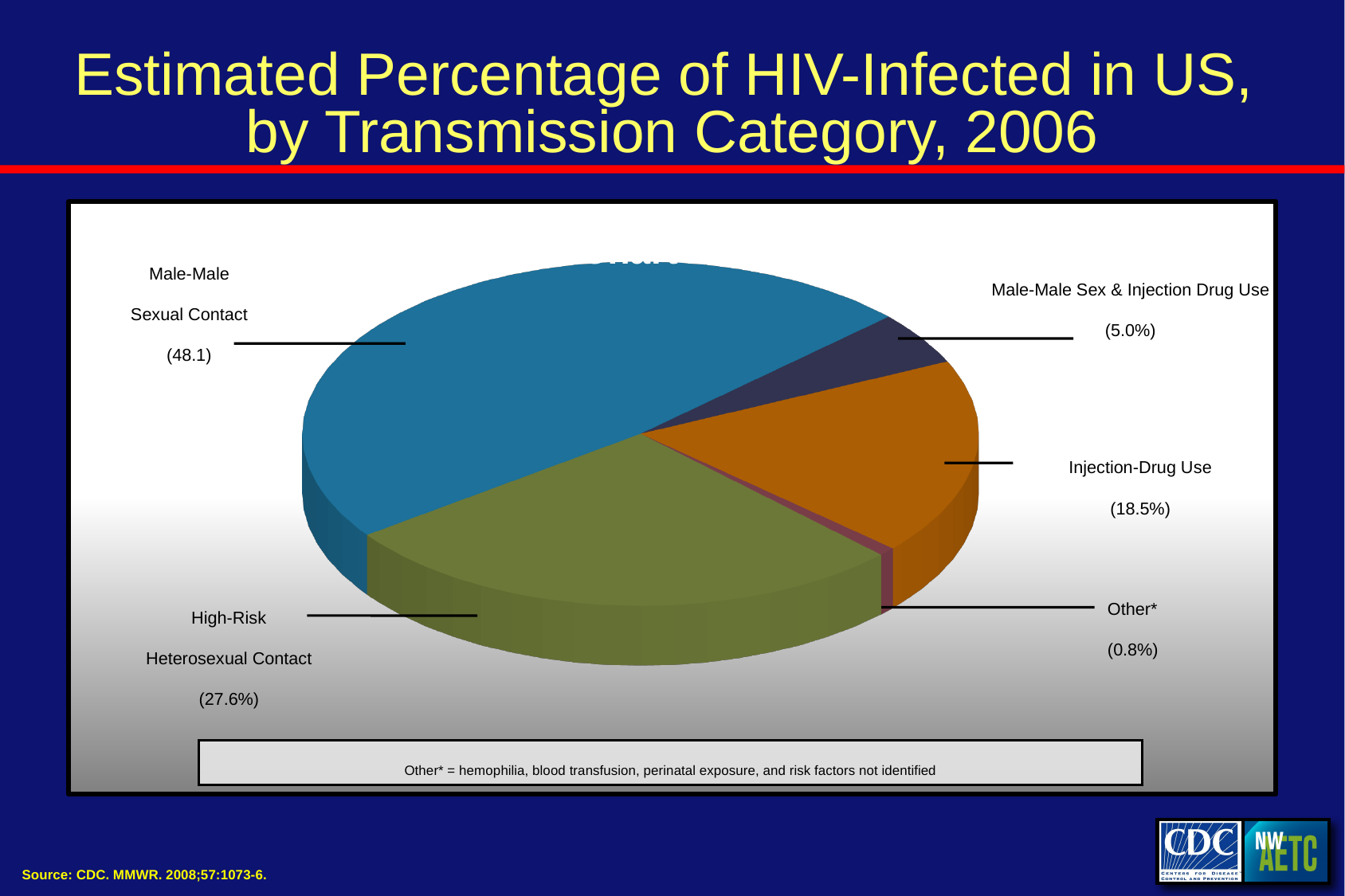
What percentage is shown for Male-Male Sex & Injection Drug Use? 5.0% What is the difference in percentage points between High-Risk Heterosexual Contact and Injection-Drug Use? 9.1 What percentage is shown for Other*? 0.8% According to the note on the chart, what does Other* include? hemophilia, blood transfusion, perinatal exposure, and risk factors not identified Which transmission category has the smallest share of the pie? Other* What kind of chart is shown on the slide? pie chart How many transmission categories are shown in the pie chart? 5 What percentage is shown for High-Risk Heterosexual Contact? 27.6% Which transmission category has the largest share of the pie? Male-Male Sexual Contact What is the value shown for Male-Male Sexual Contact? 48.1 What percentage is shown for Injection-Drug Use? 18.5% Which is larger, the share for Injection-Drug Use or the share for High-Risk Heterosexual Contact? High-Risk Heterosexual Contact